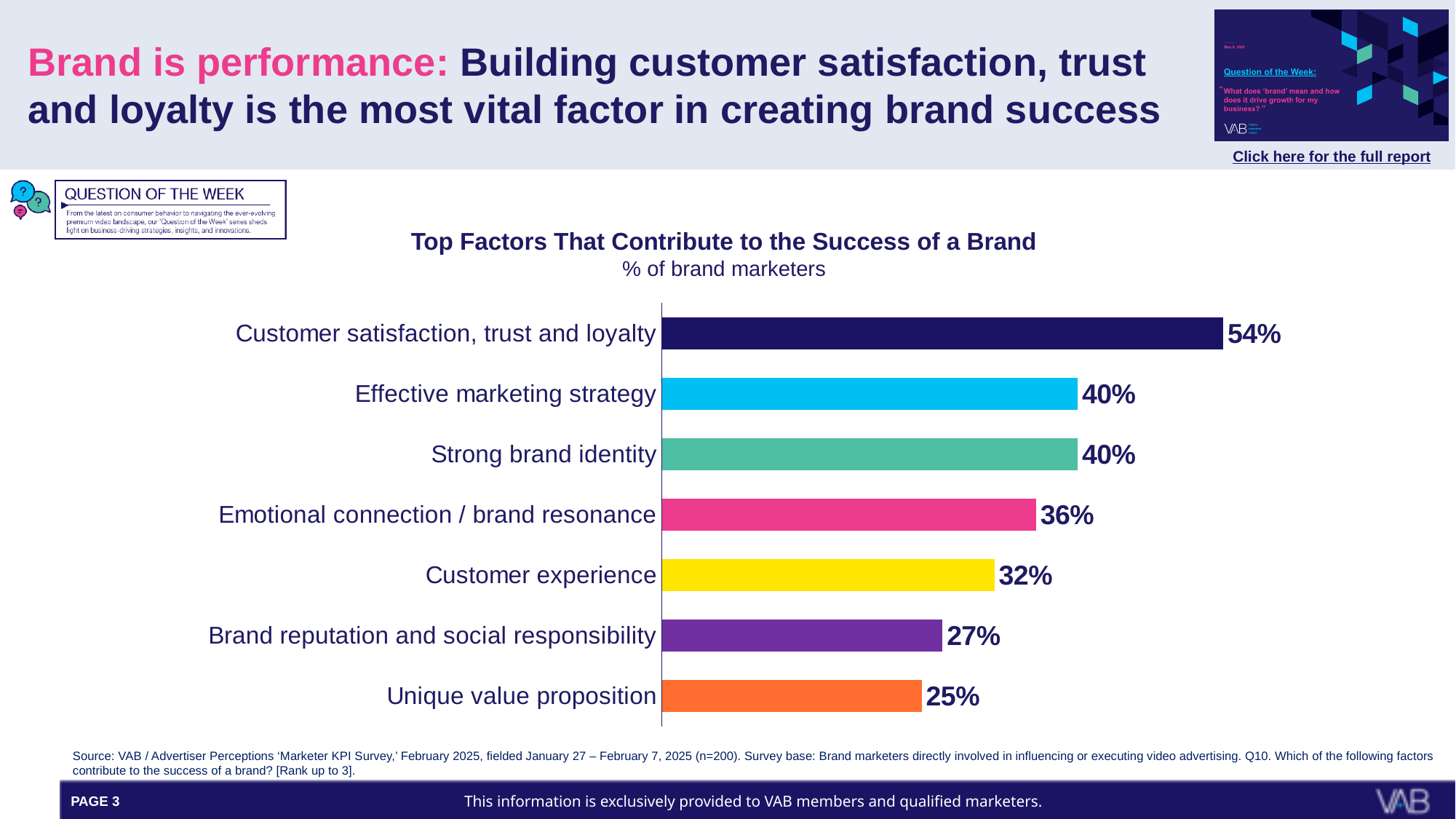
What percentage of brand marketers cited customer satisfaction, trust and loyalty as a top factor? 54% Which factor has the lowest percentage of brand marketers? Unique value proposition What is the value for Emotional connection / brand resonance? 36% What is the value for Brand reputation and social responsibility? 27% Which two factors share the same value of 40%? Effective marketing strategy and Strong brand identity Which factor has the highest percentage of brand marketers? Customer satisfaction, trust and loyalty How many factors are shown in the chart? 7 What is the difference in percentage points between Customer satisfaction, trust and loyalty and Effective marketing strategy? 14 percentage points What is the difference between Customer experience and Unique value proposition? 7 percentage points What is the title of the chart? Top Factors That Contribute to the Success of a Brand Which is larger, the value for Customer experience or the value for Brand reputation and social responsibility? Customer experience What kind of chart is shown on the slide? Bar chart